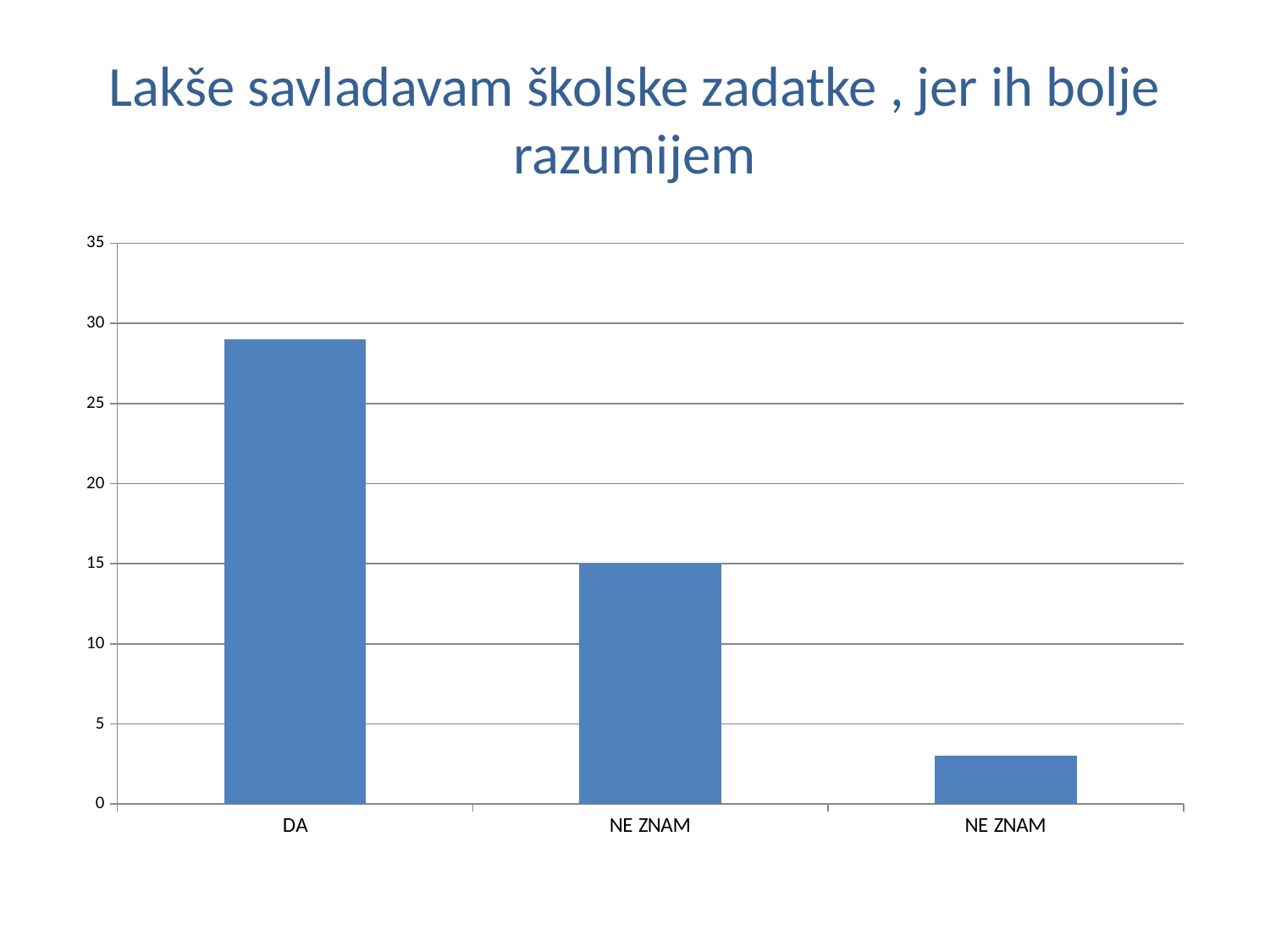
Which category has the highest bar? DA What kind of chart is shown on the slide? bar chart Is the value for DA greater or less than 25? greater Is the value for DA greater or less than 30? less What is the title of the slide? Lakše savladavam školske zadatke , jer ih bolje razumijem Is the value of the third bar (the right-hand NE ZNAM) greater or less than 5? less Do the bar values rise or fall from left to right? fall What is the value of the second bar (the middle NE ZNAM)? 15 How many bars does the chart have? 3 Which is larger, the middle bar or the right-hand bar? the middle bar Which bar is the lowest: the first (DA), the second (NE ZNAM) or the third (NE ZNAM)? the third Which is larger, the value for DA or the value of the middle bar? DA